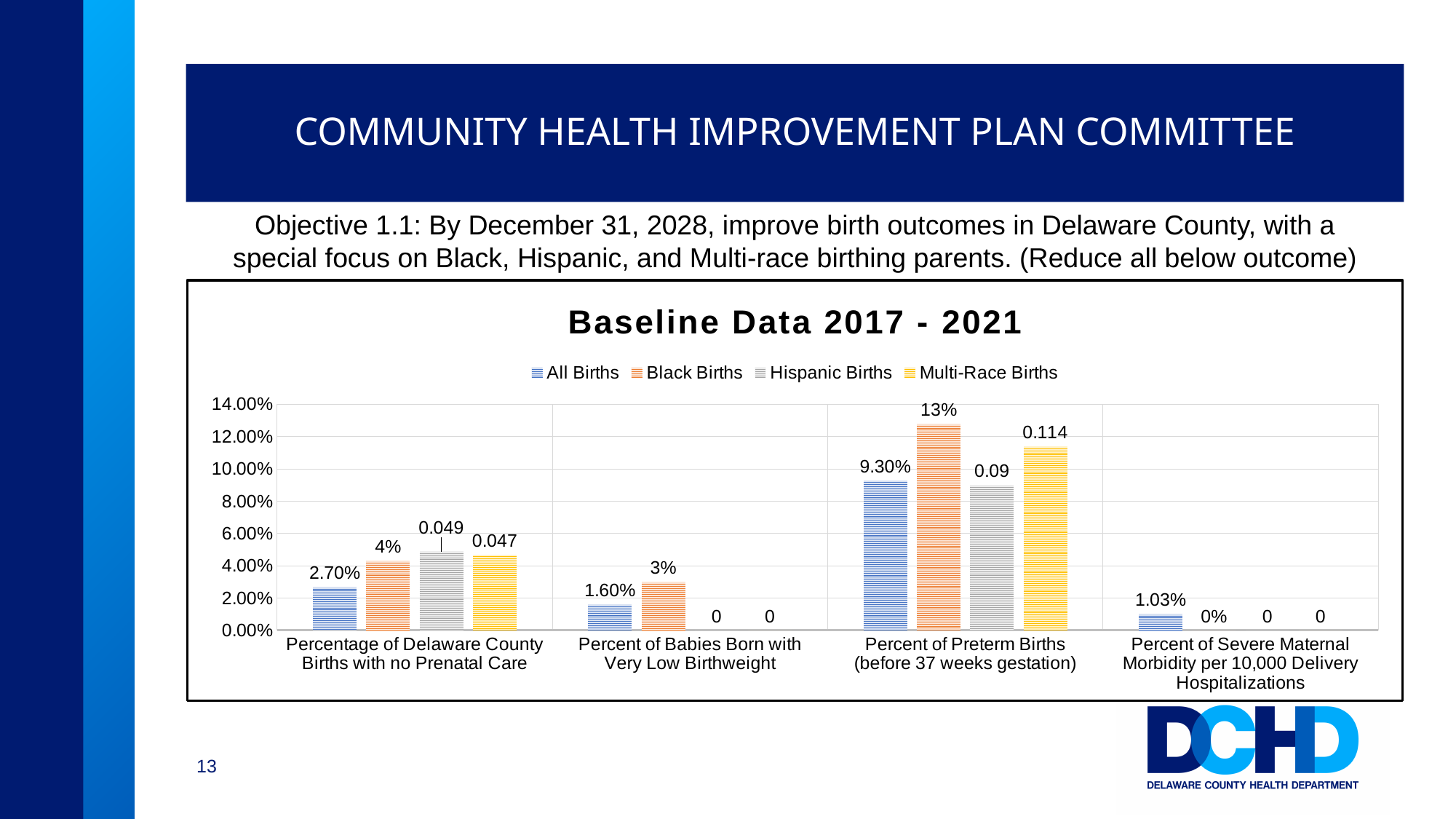
Is the value for Multi-Race Births in the 'Percent of Preterm Births (before 37 weeks gestation)' category greater or less than 10.00%? greater How many categories are shown on the x axis of the chart? 4 What is the value for All Births in the 'Percent of Preterm Births (before 37 weeks gestation)' category? 9.30% In the 'Percent of Babies Born with Very Low Birthweight' category, which is larger: All Births or Black Births? Black Births What is the value for Multi-Race Births in the 'Percentage of Delaware County Births with no Prenatal Care' category? 0.047 How many series does the chart legend list? 4 Which series has the lowest value in the 'Percentage of Delaware County Births with no Prenatal Care' category? All Births What is the value for Black Births in the 'Percent of Preterm Births (before 37 weeks gestation)' category? 13% What type of chart is shown on the slide? Bar chart What is the value for All Births in the 'Percent of Severe Maternal Morbidity per 10,000 Delivery Hospitalizations' category? 1.03% Which series has the highest value in the 'Percent of Preterm Births (before 37 weeks gestation)' category? Black Births What is the title of the chart? Baseline Data 2017 - 2021